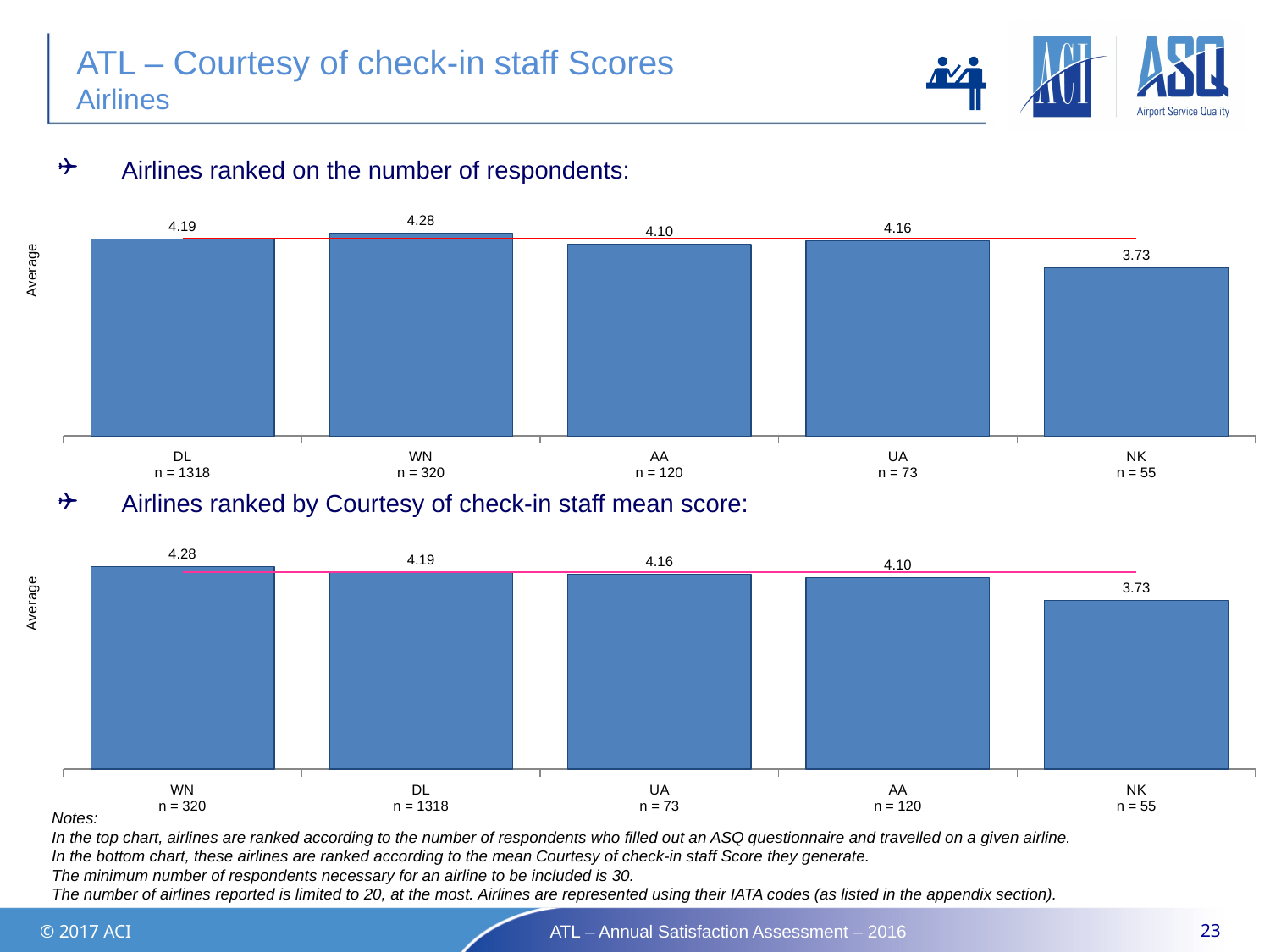
In the bottom chart (airlines ranked by mean score), which airline has the highest average score? WN In the bottom chart (airlines ranked by mean score), do the scores rise or fall from left to right? Fall What kind of chart is the bottom chart (airlines ranked by mean score)? Bar chart In the bottom chart (airlines ranked by mean score), which airline has the lowest average score? NK In the top chart (airlines ranked on the number of respondents), what is the difference between the scores for WN and AA? 0.18 In the bottom chart (airlines ranked by mean score), what is the difference between the scores for WN and NK? 0.55 In the top chart (airlines ranked on the number of respondents), what is the average score for DL? 4.19 In the top chart (airlines ranked on the number of respondents), what is the average score for NK? 3.73 How many airlines are shown in the top chart (airlines ranked on the number of respondents)? 5 In the bottom chart (airlines ranked by mean score), which has the higher score, UA or AA? UA What is the label on the vertical axis of the top chart? Average In the top chart (airlines ranked on the number of respondents), how many respondents does DL have? n = 1318